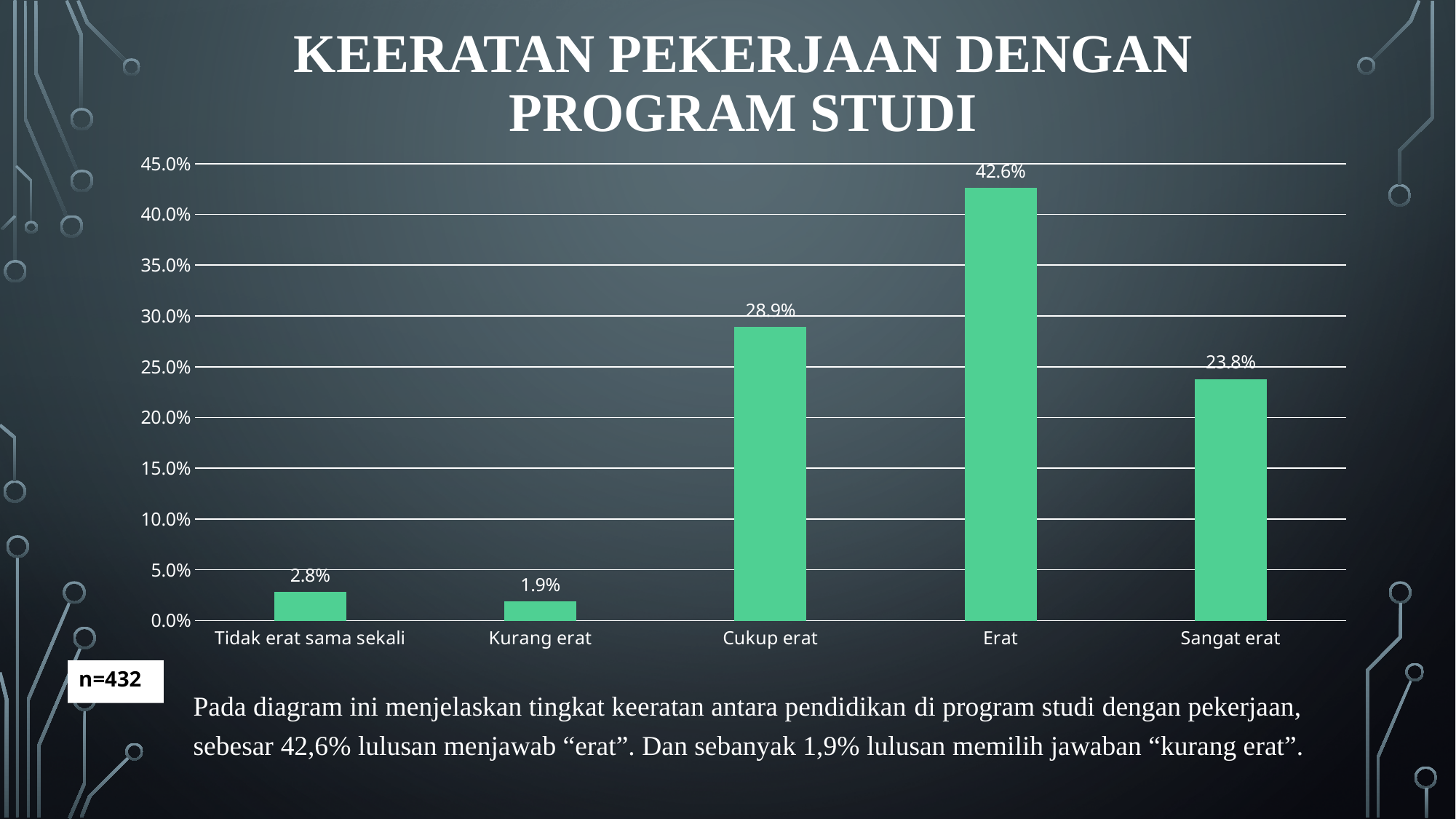
Which category has the highest value? Erat Is the value for "Cukup erat" greater or less than 30.0%? less What is the title of the slide containing the chart? KEERATAN PEKERJAAN DENGAN PROGRAM STUDI How many categories are shown on the x axis? 5 Which category has the lowest value? Kurang erat What is the value for "Kurang erat"? 1.9% What is the difference between the values for "Erat" and "Cukup erat"? 13.7% What is the value for "Sangat erat"? 23.8% What kind of chart is shown on the slide? bar chart What is the value for "Erat"? 42.6% What is the value for "Tidak erat sama sekali"? 2.8% Which is larger, the value for "Cukup erat" or the value for "Sangat erat"? Cukup erat